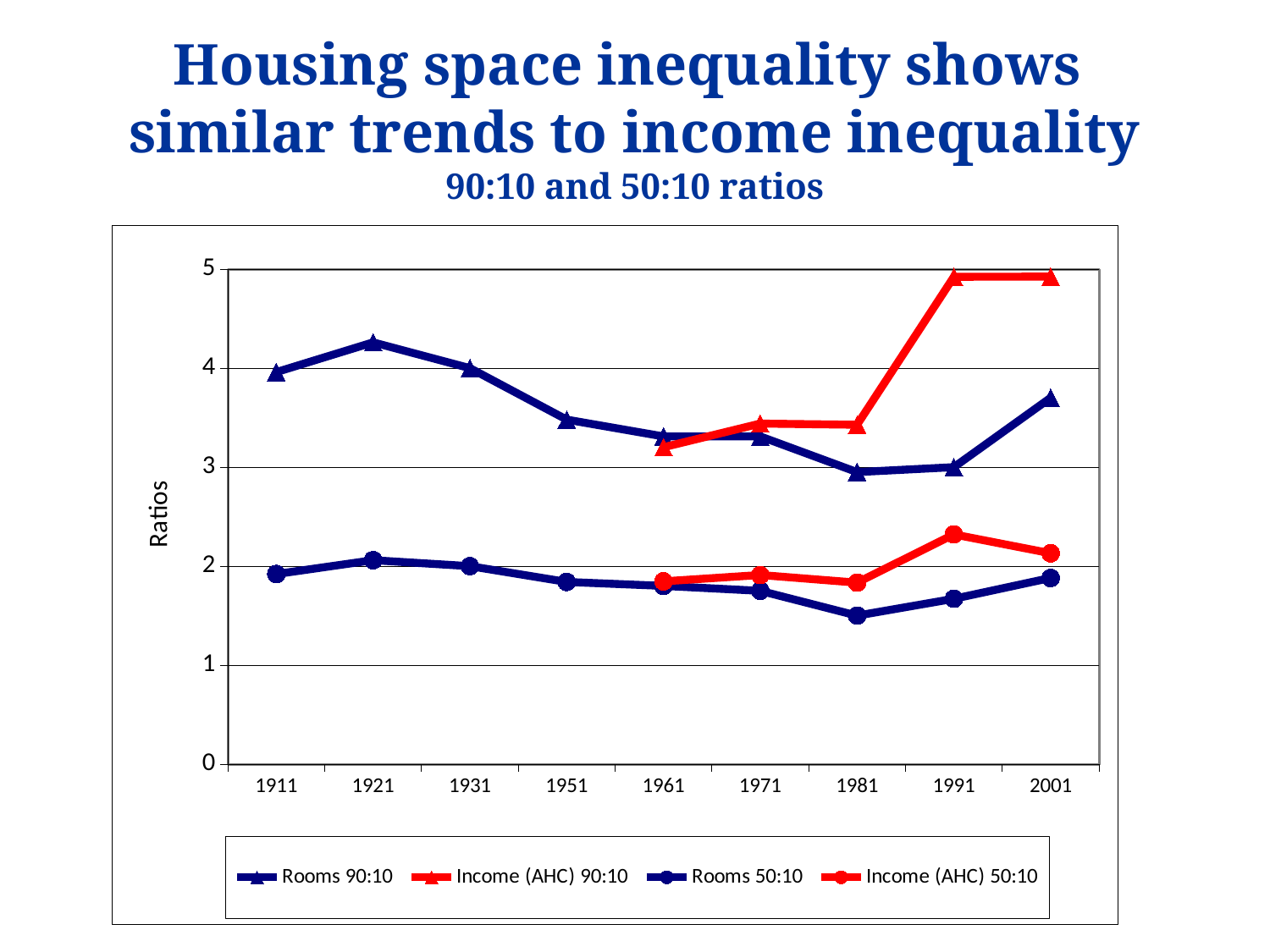
Does the Rooms 90:10 ratio rise or fall between 1921 and 1981? Fall In which year is the Rooms 50:10 ratio lowest? 1981 Is the Income (AHC) 90:10 ratio in 2001 greater or less than 4? greater How many series does the legend list? 4 In which year is the Rooms 90:10 ratio highest? 1921 In which year is the Income (AHC) 90:10 ratio lowest? 1961 In which year is the Income (AHC) 50:10 ratio highest? 1991 Is the Rooms 50:10 ratio in 1981 greater or less than 2? less How many years are shown on the x axis? 9 In 2001, which is larger: the Income (AHC) 90:10 ratio or the Rooms 90:10 ratio? Income (AHC) 90:10 Is the Rooms 90:10 ratio in 1921 greater or less than 4? greater What kind of chart is shown on the slide? Line chart